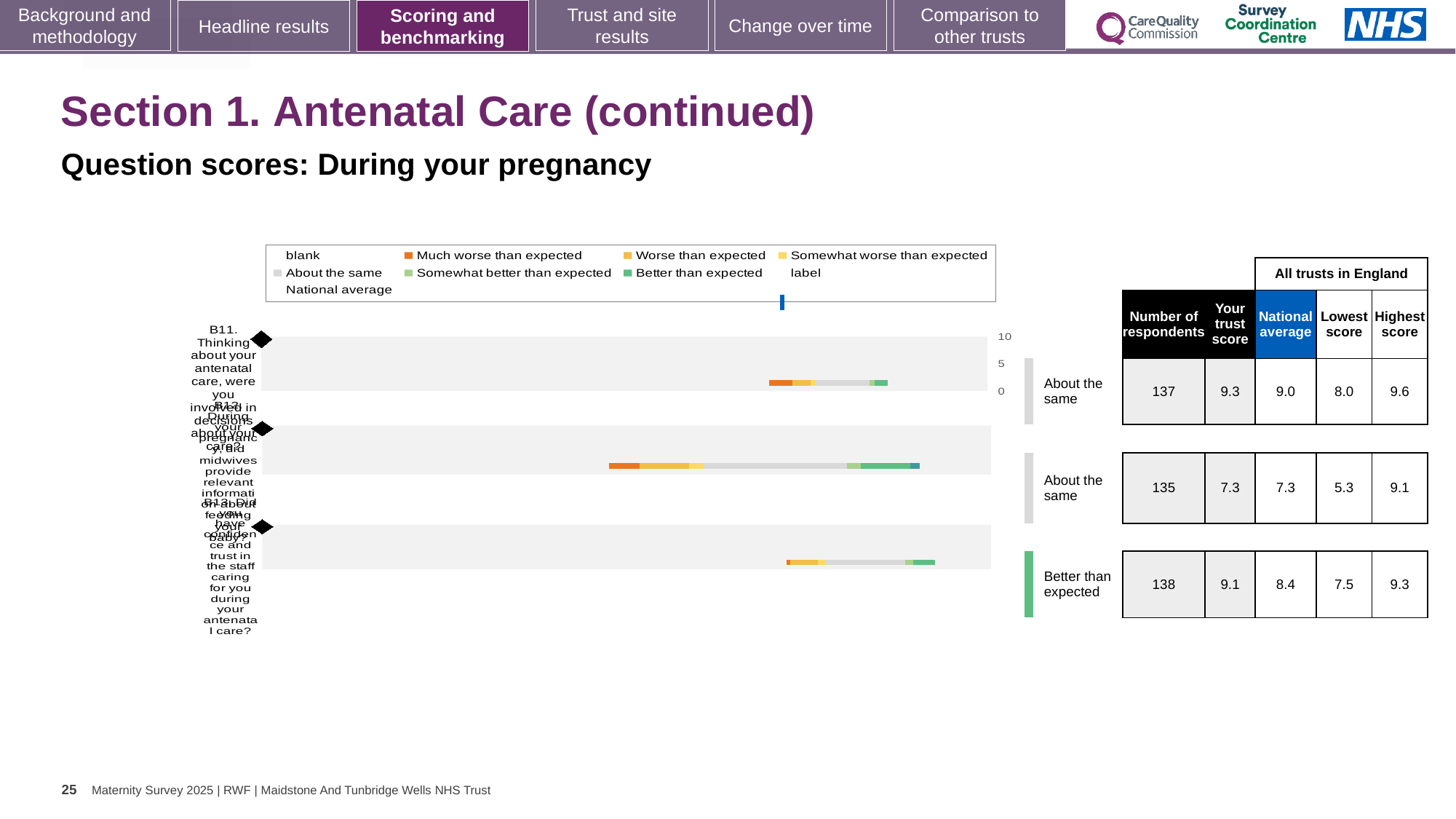
Which question has the highest trust score? B11 What is the national average for question B12 (midwives provide relevant information about feeding your baby)? 7.3 What benchmark category is shown for question B13? Better than expected For question B11, which is larger: the trust score or the national average? the trust score What colour does the legend use for 'Much worse than expected'? orange How many respondents answered question B13 (confidence and trust in the staff caring for you)? 138 What is the lowest score across all trusts in England for question B12? 5.3 What kind of chart is shown on the slide? bar chart What is the trust score for question B11 (involved in decisions about your care)? 9.3 What is the difference between the trust score and the national average for question B13? 0.7 How many questions (bars) are plotted in the chart? 3 Which question has the lowest trust score? B12